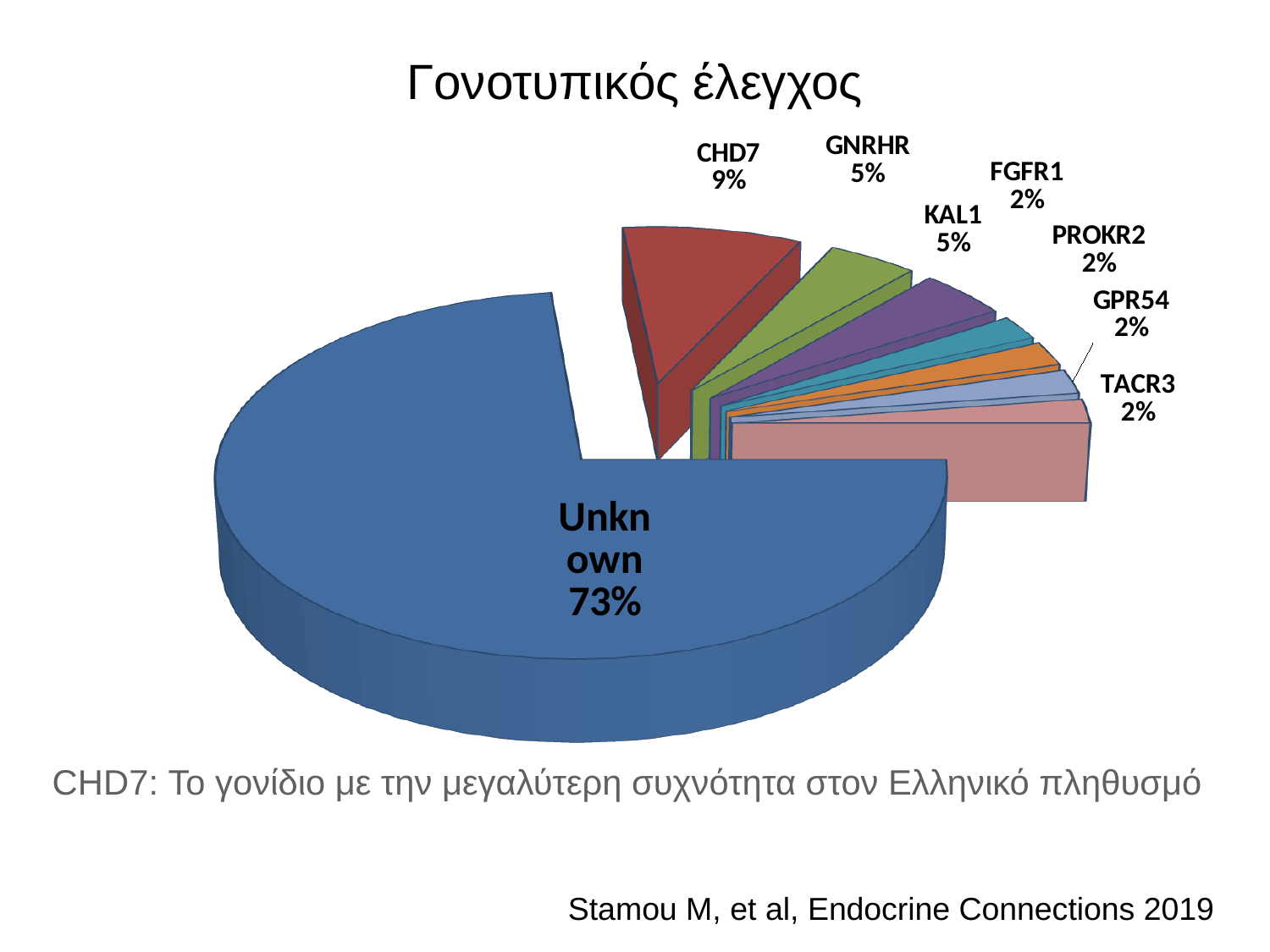
How many slices does the pie chart have? 8 What percentage is shown for GNRHR? 5% What share of the pie does the Unknown slice represent? 73% Which slice of the pie is the largest? Unknown What percentage is shown for CHD7? 9% What kind of chart is shown on the slide? Pie chart Among the named genes (excluding Unknown), which has the largest share? CHD7 What percentage is shown for FGFR1? 2% What is the difference in percentage points between CHD7 and GNRHR? 4 Which is larger, the share for CHD7 or the share for KAL1? CHD7 What percentage is shown for KAL1? 5% What percentage is shown for TACR3? 2%